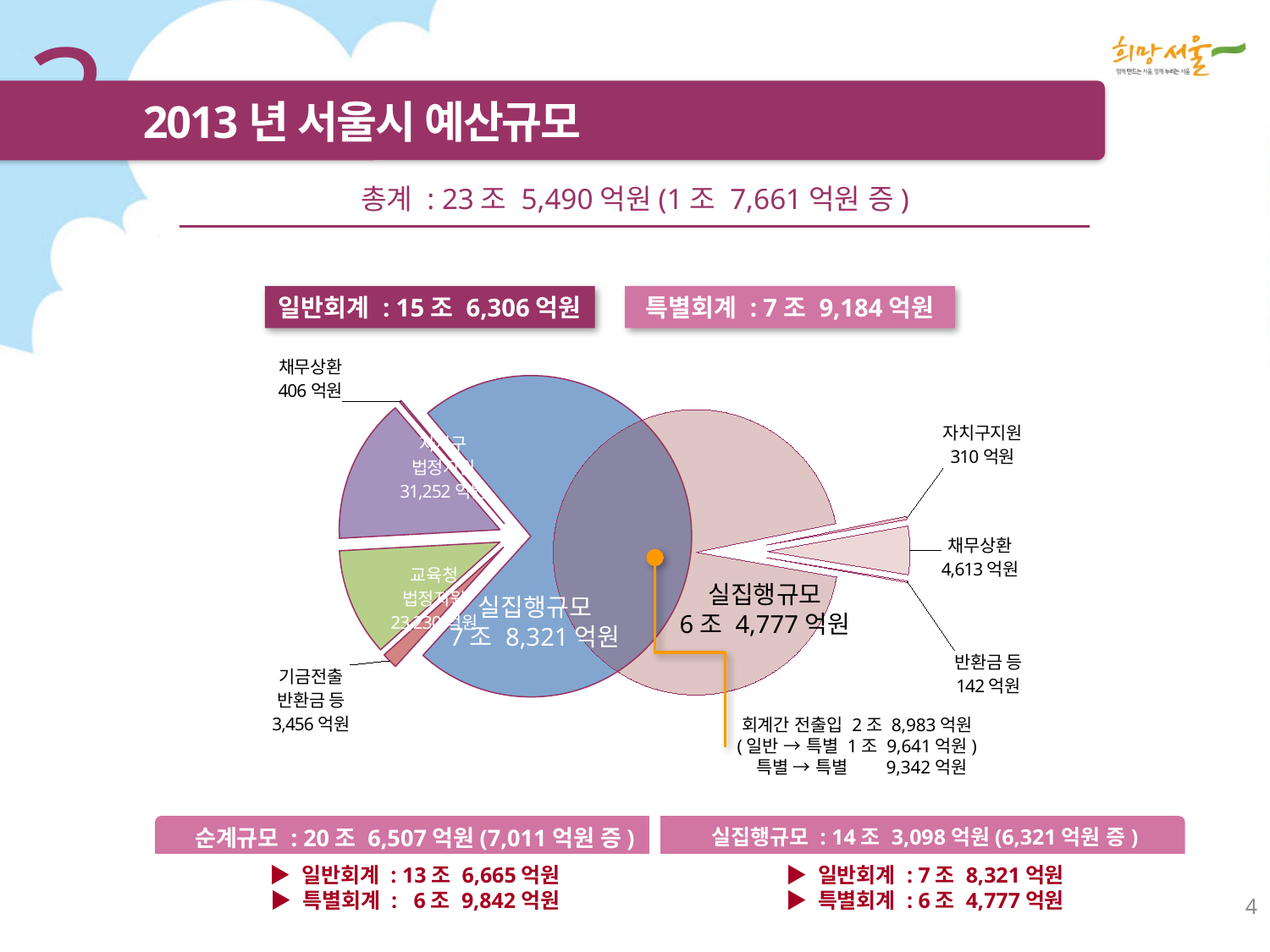
Which account has the larger 채무상환 value, 일반회계 (left pie) or 특별회계 (right pie)? 특별회계 What type of chart is used to show the 일반회계 and 특별회계 budgets on this slide? Pie chart In the 일반회계 pie chart on the left, what is the value for 기금전출 반환금 등? 3,456 억원 In the 특별회계 pie chart on the right, which labelled slice has the smallest value? 반환금 등 In the 특별회계 pie chart on the right, what is the value for 자치구지원? 310 억원 In the 일반회계 pie chart on the left, what is the value for 채무상환? 406 억원 In the 특별회계 pie chart on the right, what is the 실집행규모 value? 6조 4,777 억원 In the 특별회계 pie chart on the right, which slice is the largest? 실집행규모 In the 일반회계 pie chart on the left, what is the 실집행규모 value? 7조 8,321 억원 What is the difference between the 채무상환 value in the 특별회계 pie chart and the 채무상환 value in the 일반회계 pie chart? 4,207 억원 In the 특별회계 pie chart on the right, what is the value for 채무상환? 4,613 억원 In the 특별회계 pie chart on the right, what is the value for 반환금 등? 142 억원